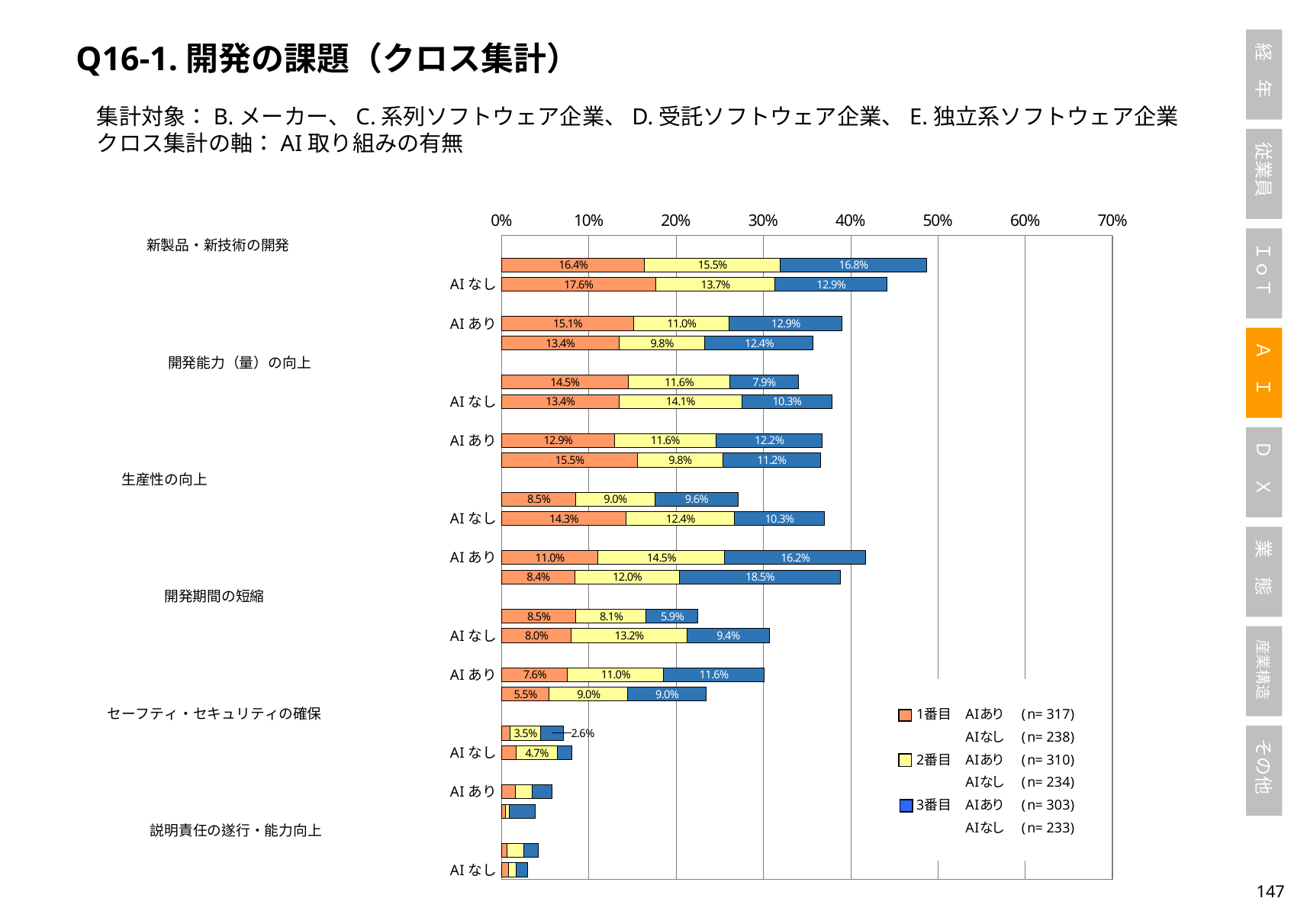
For 新製品・新技術の開発, how much larger is the 1番目 value for AI なし than for AI あり? 1.2 percentage points Is the total stacked bar for 新製品・新技術の開発 in the AI あり group greater or less than 40%? greater What is the 3番目 value for 新製品・新技術の開発 in the AI あり group? 16.8% What is the total of the stacked bar for 新製品・新技術の開発 in the AI あり group? 48.7% What is the 2番目 value for 新製品・新技術の開発 in the AI なし group? 13.7% According to the legend, what is the n for 3番目 AI なし? 233 How many series does the legend list? 3 According to the legend, what is the n for 1番目 AI あり? 317 For 新製品・新技術の開発, which group has the larger 3番目 value, AI あり or AI なし? AI あり What is the total of the stacked bar for 新製品・新技術の開発 in the AI なし group? 44.2% What is the 1番目 value for 新製品・新技術の開発 in the AI なし group? 17.6% What kind of chart is shown on the slide? Stacked bar chart